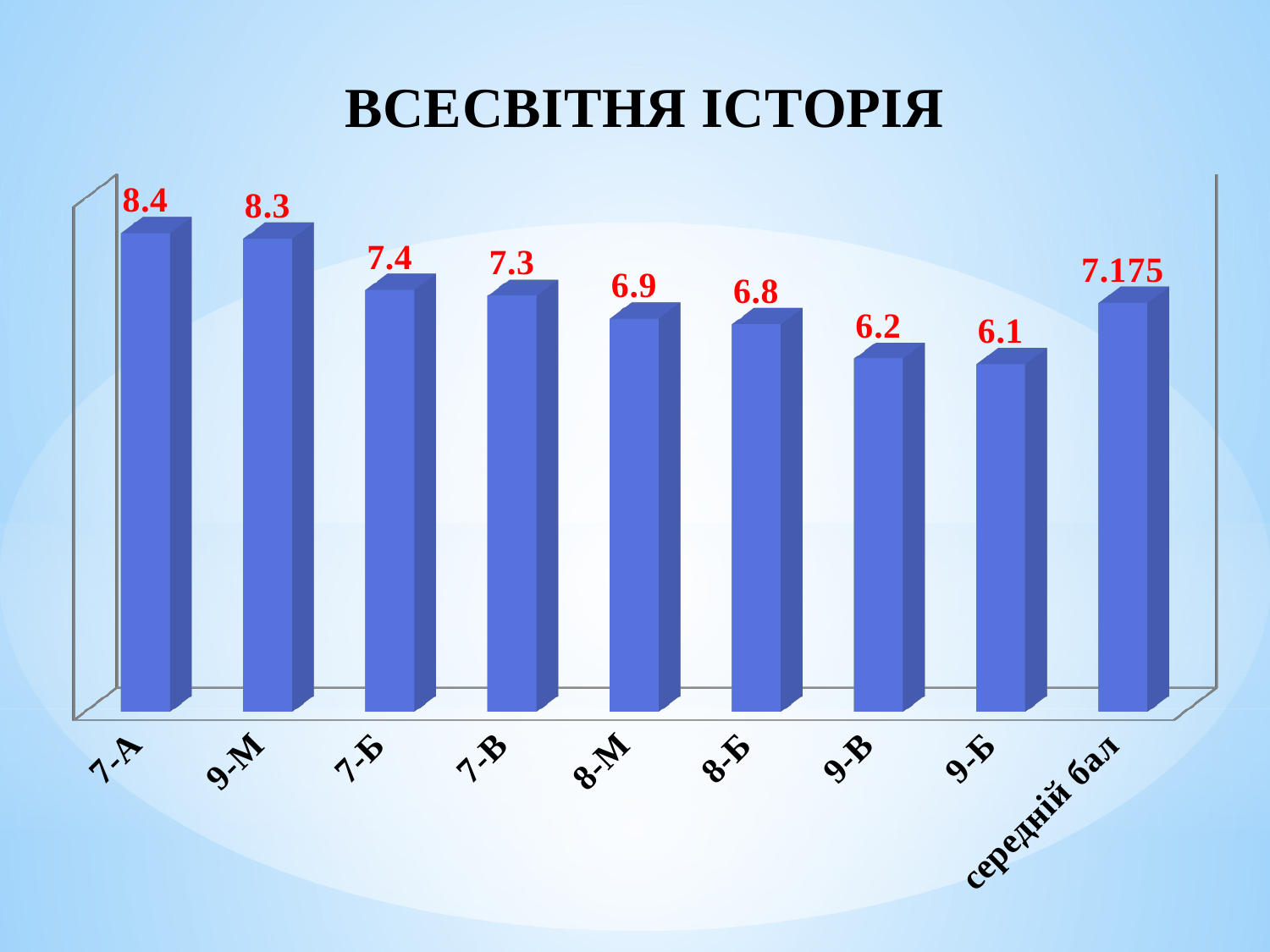
Which category has the highest value? 7-А What is the value for 9-Б? 6.1 What is the title of the slide? ВСЕСВІТНЯ ІСТОРІЯ What is the difference between the values for 7-Б and 8-Б? 0.6 What is the value for середній бал? 7.175 Which category has the lowest value? 9-Б How many categories are shown on the x axis? 9 What kind of chart is shown on the slide? bar chart What is the value for 7-А? 8.4 Which is larger, the value for 9-М or the value for 7-В? 9-М What is the difference between the values for 7-А and 9-Б? 2.3 What is the value for 8-М? 6.9